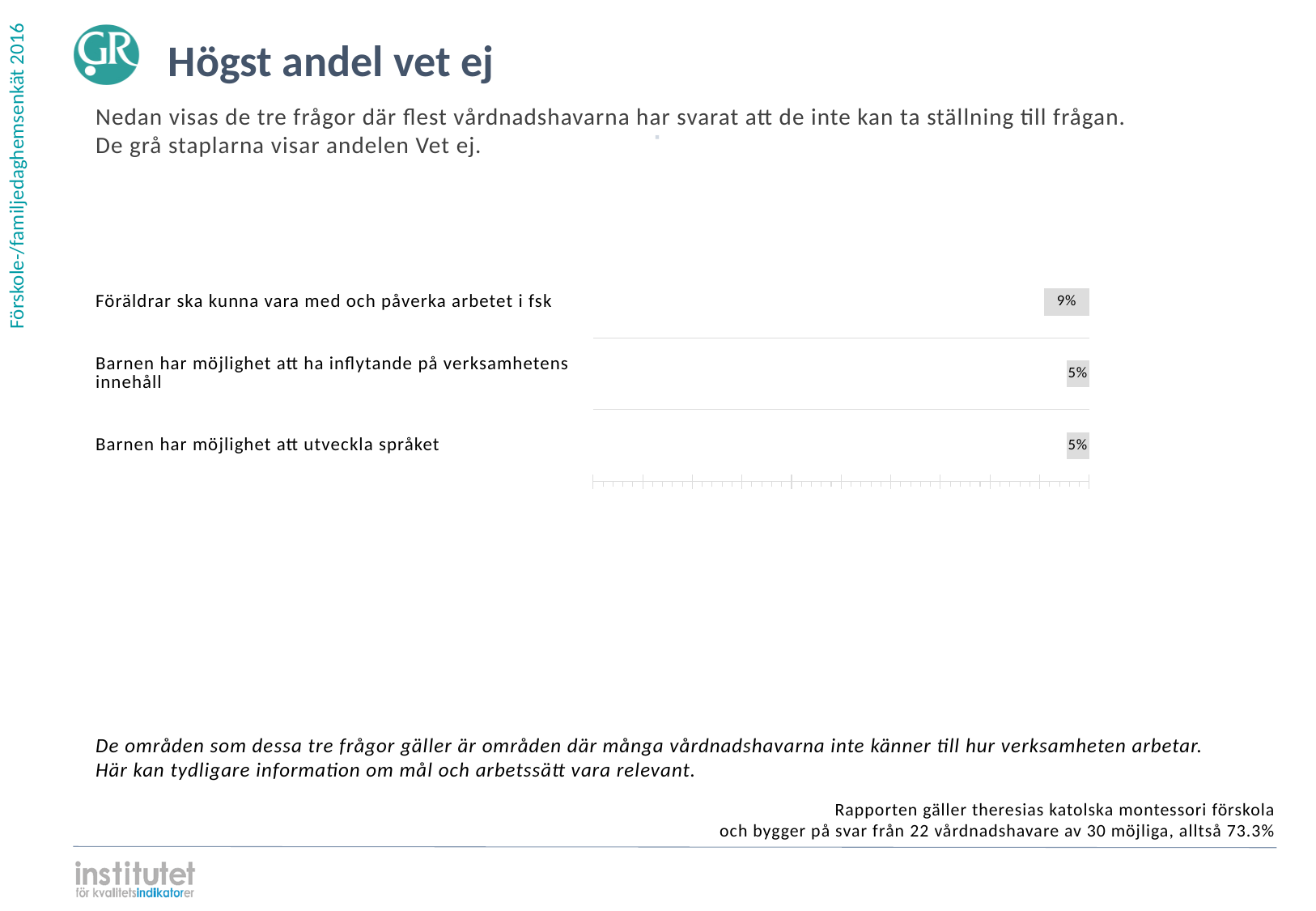
Which is larger: the value for "Föräldrar ska kunna vara med och påverka arbetet i fsk" or the value for "Barnen har möjlighet att ha inflytande på verksamhetens innehåll"? Föräldrar ska kunna vara med och påverka arbetet i fsk What is the value for "Barnen har möjlighet att utveckla språket"? 5% Do the values for "Barnen har möjlighet att ha inflytande på verksamhetens innehåll" and "Barnen har möjlighet att utveckla språket" have the same value? Yes What is the difference between the value for "Föräldrar ska kunna vara med och påverka arbetet i fsk" and the value for "Barnen har möjlighet att utveckla språket"? 4% Which category has the highest share of "Vet ej" answers? Föräldrar ska kunna vara med och påverka arbetet i fsk How many categories are shown in the chart? 3 What is the title of the slide containing the chart? Högst andel vet ej What is the value for "Barnen har möjlighet att ha inflytande på verksamhetens innehåll"? 5% What kind of chart is shown on the slide? Bar chart What is the value for "Föräldrar ska kunna vara med och påverka arbetet i fsk"? 9% What colour are the bars in the chart? Grey